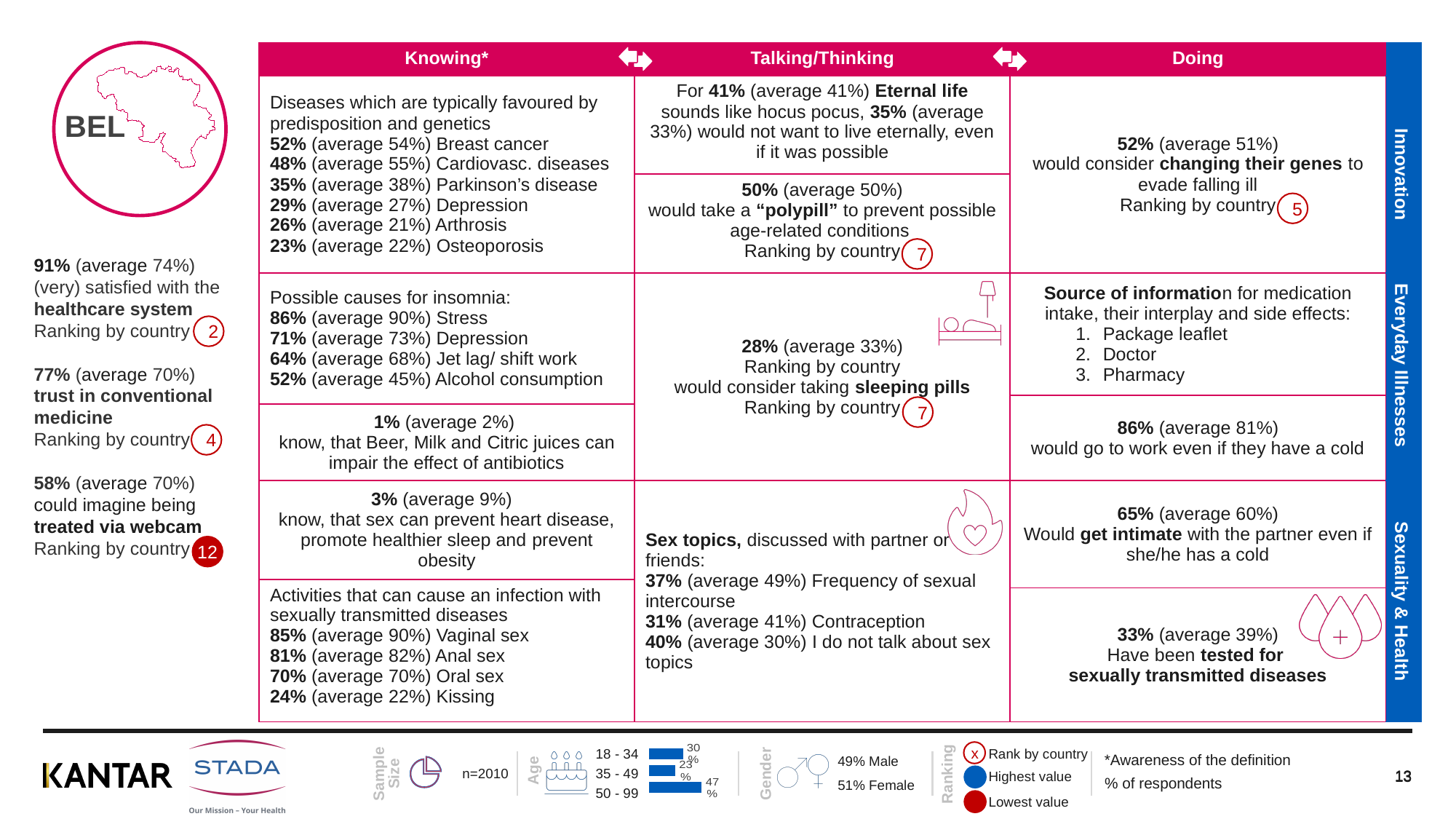
In the Age bar chart, what is the total of the three age group values? 100% In the Age bar chart, what is the value for the 18 - 34 group? 30% In the Age bar chart, which is larger: the value for 18 - 34 or the value for 35 - 49? 18 - 34 In the Age bar chart, what is the value for the 35 - 49 group? 23% What is the sample size (n) shown next to the Age bar chart? n=2010 What kind of chart is the Age chart at the bottom of the slide? bar chart In the Age bar chart, which age group has the lowest value? 35 - 49 In the Age bar chart, what is the difference between the 18 - 34 group and the 35 - 49 group? 7% In the Age bar chart, what is the value for the 50 - 99 group? 47% In the Age bar chart, what is the difference between the 50 - 99 group and the 18 - 34 group? 17% In the Age bar chart, which age group has the highest value? 50 - 99 How many age groups are shown in the Age bar chart? 3